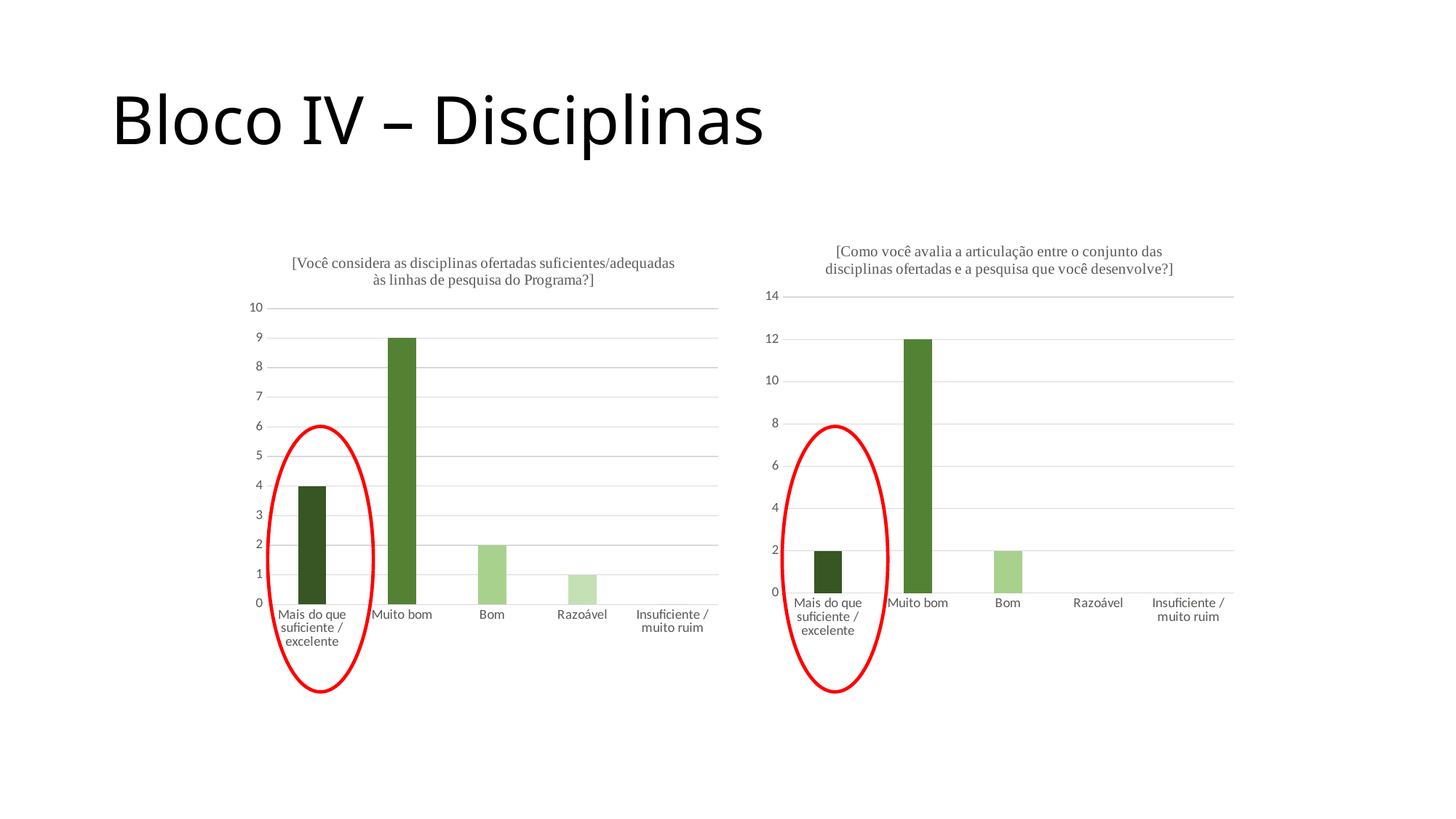
In the left chart (disciplinas suficientes/adequadas), what is the difference between Muito bom and Bom? 7 In the left chart (disciplinas suficientes/adequadas), what is the value for Mais do que suficiente / excelente? 4 In the right chart (articulação entre disciplinas e pesquisa), which category has the highest value? Muito bom In the left chart (disciplinas suficientes/adequadas), what is the value for Muito bom? 9 Which is larger: the value for Mais do que suficiente / excelente in the left chart or in the right chart? Left chart In the right chart (articulação entre disciplinas e pesquisa), what is the difference between Muito bom and Mais do que suficiente / excelente? 10 In the right chart (articulação entre disciplinas e pesquisa), is the value for Muito bom greater or less than 10? greater In the right chart (articulação entre disciplinas e pesquisa), what is the value for Muito bom? 12 In the right chart (articulação entre disciplinas e pesquisa), what is the value for Bom? 2 In the left chart (disciplinas suficientes/adequadas), how many categories are shown on the x axis? 5 What type of chart is the left chart (disciplinas suficientes/adequadas)? Bar chart In the left chart (disciplinas suficientes/adequadas), which category has the highest value? Muito bom